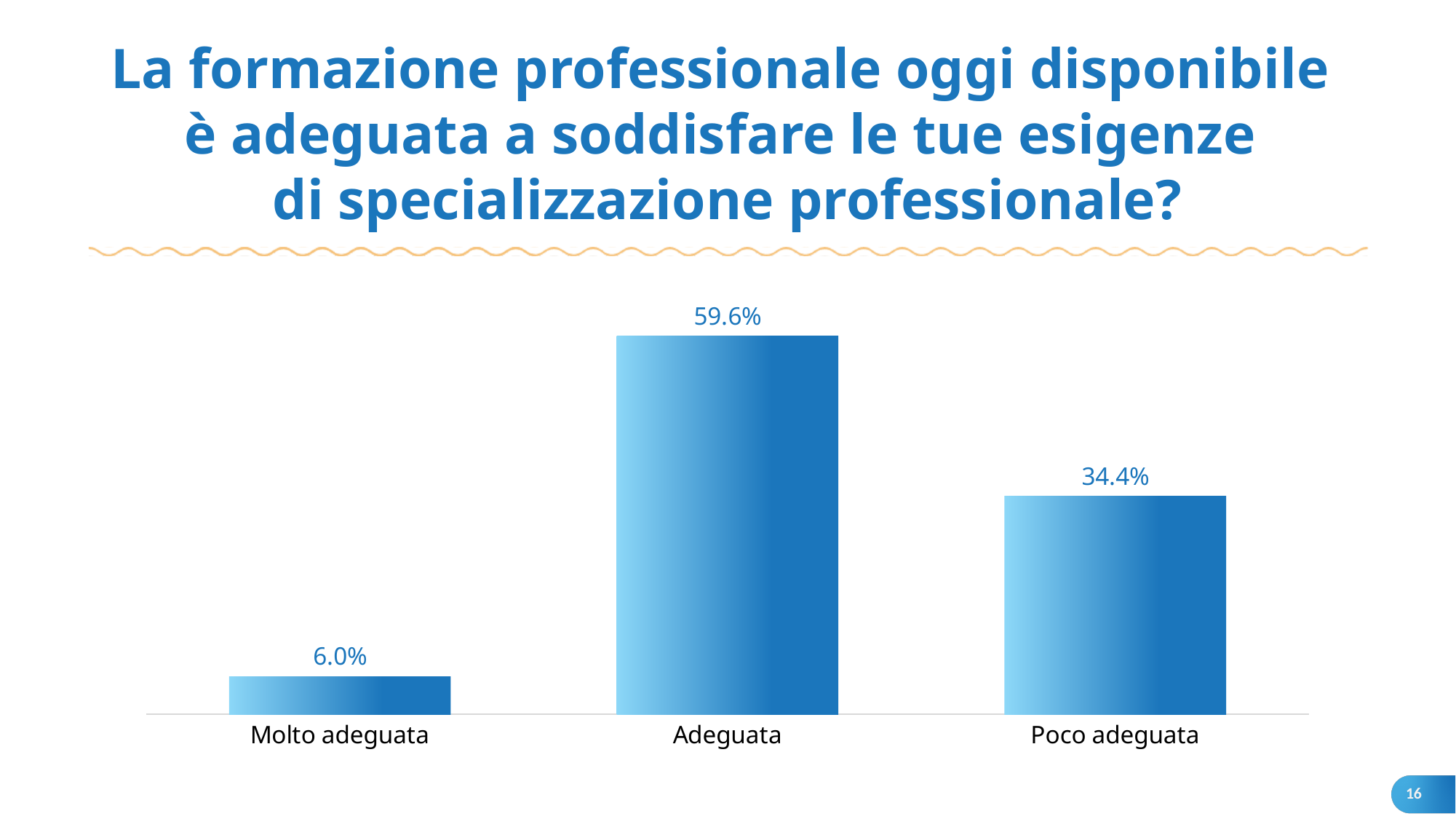
How many categories are shown in the chart? 3 What is the value for Poco adeguata? 34.4% What is the value for Adeguata? 59.6% Which is larger, the value for Poco adeguata or the value for Molto adeguata? Poco adeguata What is the value for Molto adeguata? 6.0% What is the difference between the values for Adeguata and Poco adeguata? 25.2% Which category has the lowest value? Molto adeguata What is the label of the middle category on the x axis? Adeguata What is the total of the three values shown in the chart? 100.0% Which category has the highest value? Adeguata What is the difference between the values for Poco adeguata and Molto adeguata? 28.4% What kind of chart is shown on the slide? Bar chart